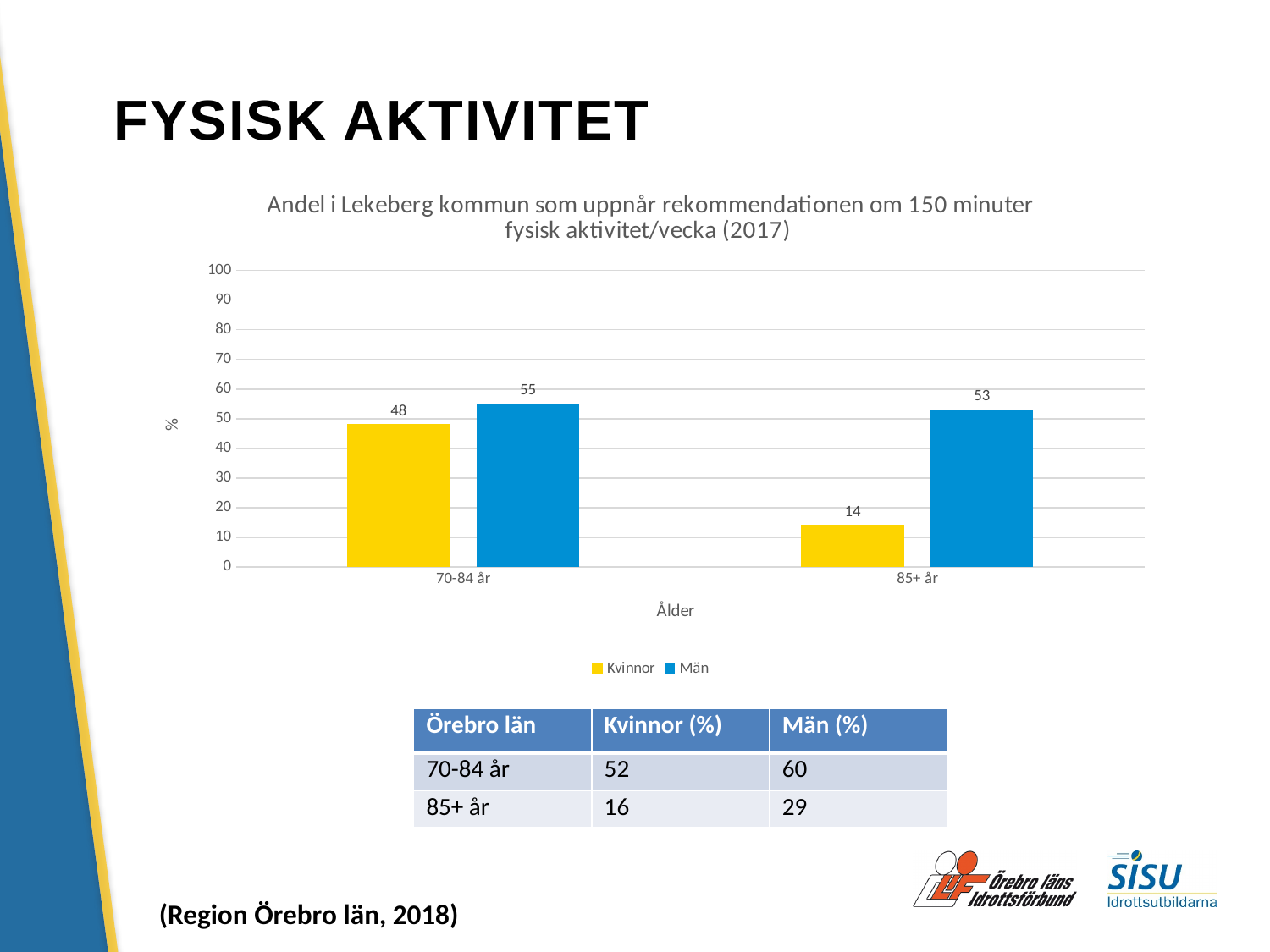
What is the difference between Män and Kvinnor in the 85+ år category? 39 What is the value for Män in the 85+ år category? 53 How many age categories are shown on the x axis? 2 Which bar has the lowest value in the chart? Kvinnor, 85+ år What is the value for Kvinnor in the 85+ år category? 14 How many series does the legend list? 2 What kind of chart is shown on the slide? bar chart Is the value for Kvinnor in the 85+ år category greater or less than 20? less What is the difference between the Kvinnor values for 70-84 år and 85+ år? 34 Which is larger: Män for 70-84 år or Män for 85+ år? Män for 70-84 år What is the value for Kvinnor in the 70-84 år category? 48 Which series has the highest value in the 70-84 år category? Män